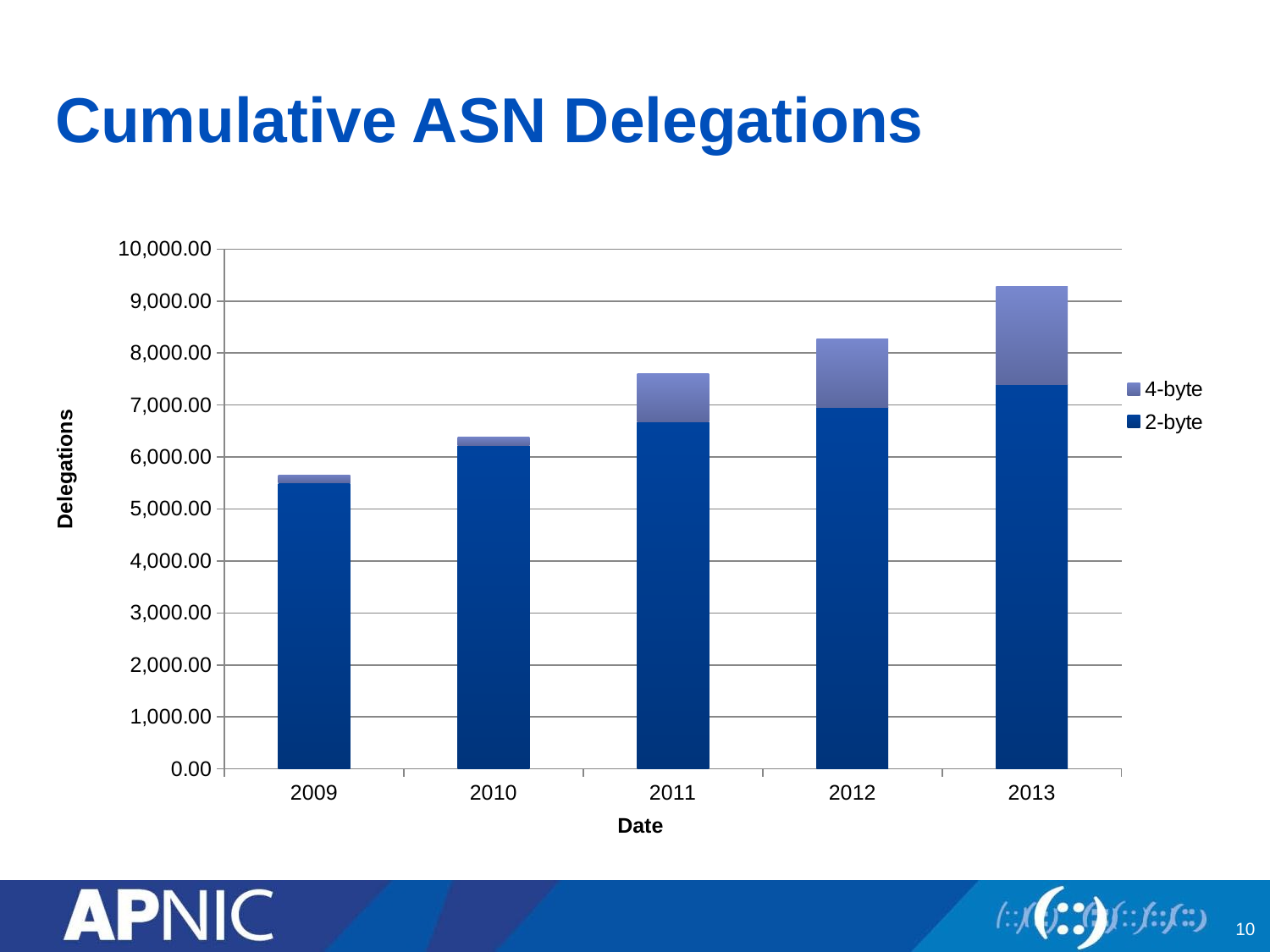
Which year has the lowest total cumulative ASN delegations? 2009 What is the label of the y axis? Delegations Which is larger, the total bar for 2012 or the total bar for 2011? 2012 Is the total bar for 2013 greater or less than 9,000.00? greater How many series does the legend list? 2 What kind of chart is shown on the slide? stacked bar chart Is the total bar for 2011 greater or less than 7,000.00? greater Is the total bar for 2009 greater or less than 6,000.00? less Do the total delegations rise or fall from 2009 to 2013? rise In which year is the 4-byte segment the largest? 2013 Which year has the highest total cumulative ASN delegations? 2013 How many years are shown on the x axis of the chart? 5